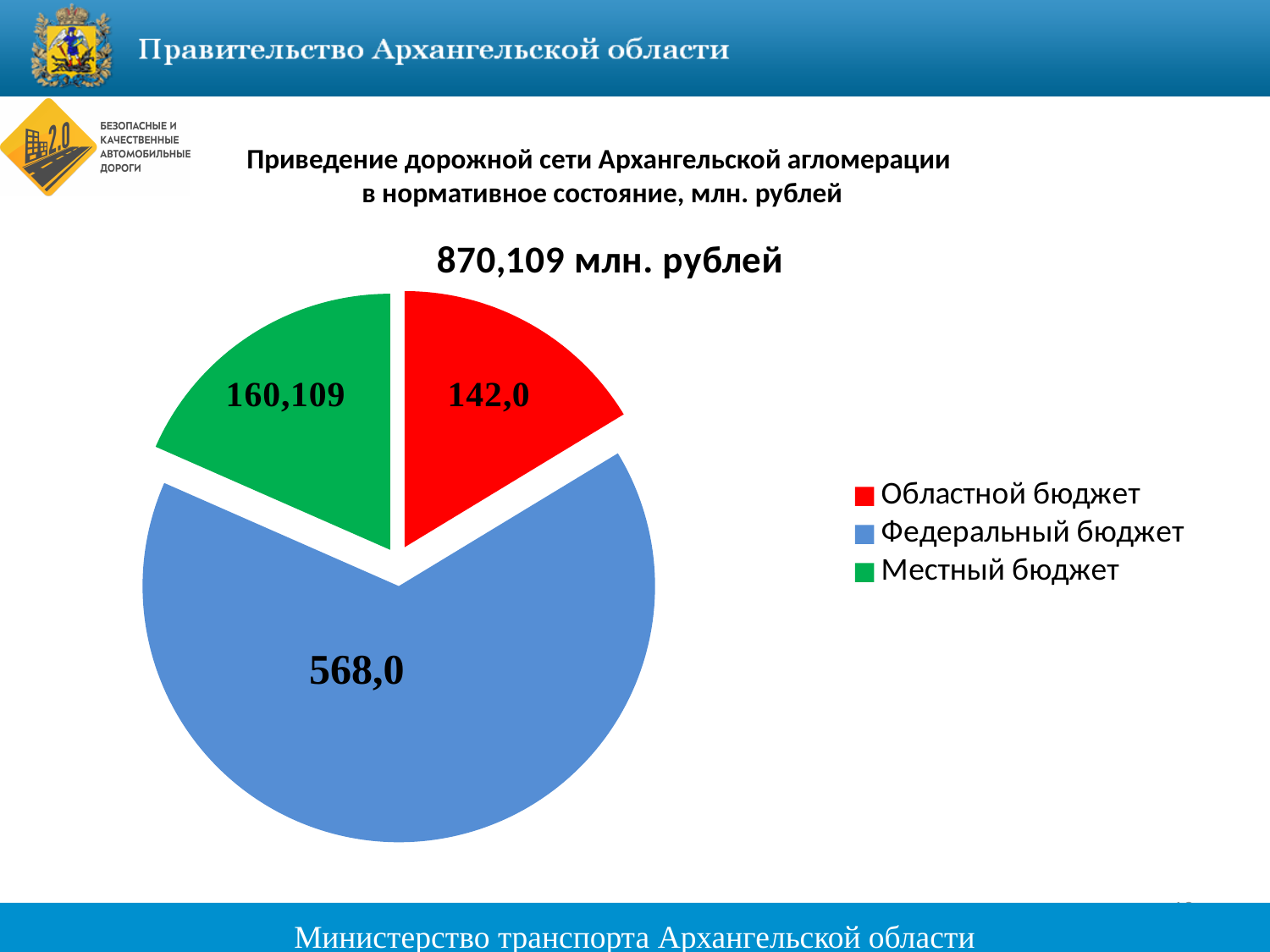
Which budget source has the smallest slice of the pie? Областной бюджет What is the value for Областной бюджет? 142,0 What is the value for Местный бюджет? 160,109 What kind of chart is shown on the slide? Pie chart Which budget source has the largest slice of the pie? Федеральный бюджет How many slices does the pie chart have? 3 How many entries does the legend list? 3 Which is larger, Местный бюджет or Областной бюджет? Местный бюджет What is the difference between the values for Федеральный бюджет and Областной бюджет? 426,0 What is the value for Федеральный бюджет? 568,0 What total amount is shown as the chart title? 870,109 млн. рублей What is the difference between the values for Местный бюджет and Областной бюджет? 18,109